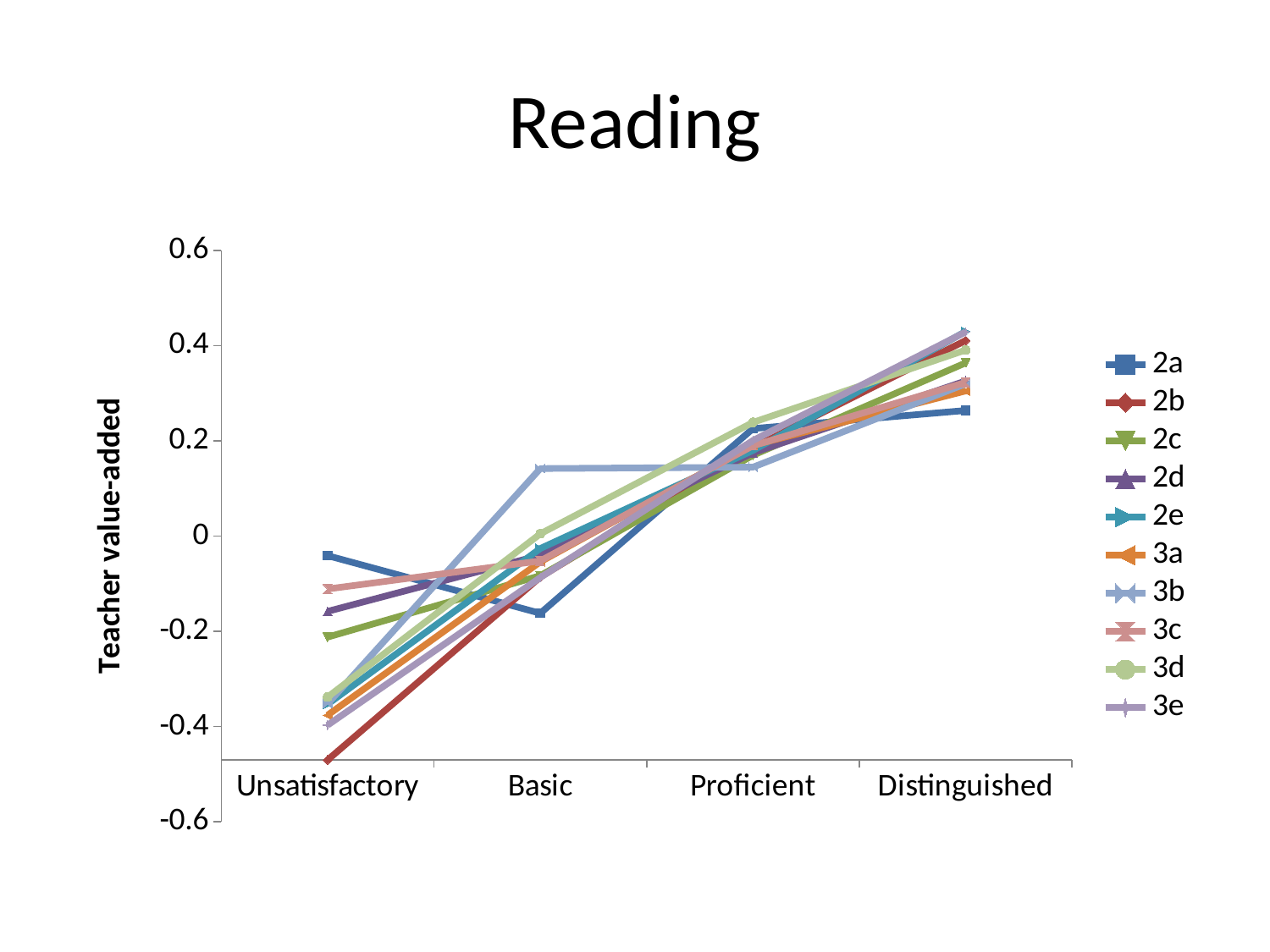
How many series does the legend list? 10 Is the value for series 3b at Basic greater or less than 0? greater Which series has the lowest value at Distinguished? 2a Is the value for series 2b at Unsatisfactory greater or less than -0.4? less At Distinguished, which series has the larger value, 2a or 2b? 2b Does the value for series 2b rise or fall from Unsatisfactory to Distinguished? rise How many categories are shown on the x axis? 4 What kind of chart is shown on the slide? line chart Which series has the highest value at Unsatisfactory? 2a What is the title of the y axis? Teacher value-added Is the value for series 2a at Distinguished greater or less than 0.4? less Which series has the lowest value at Unsatisfactory? 2b